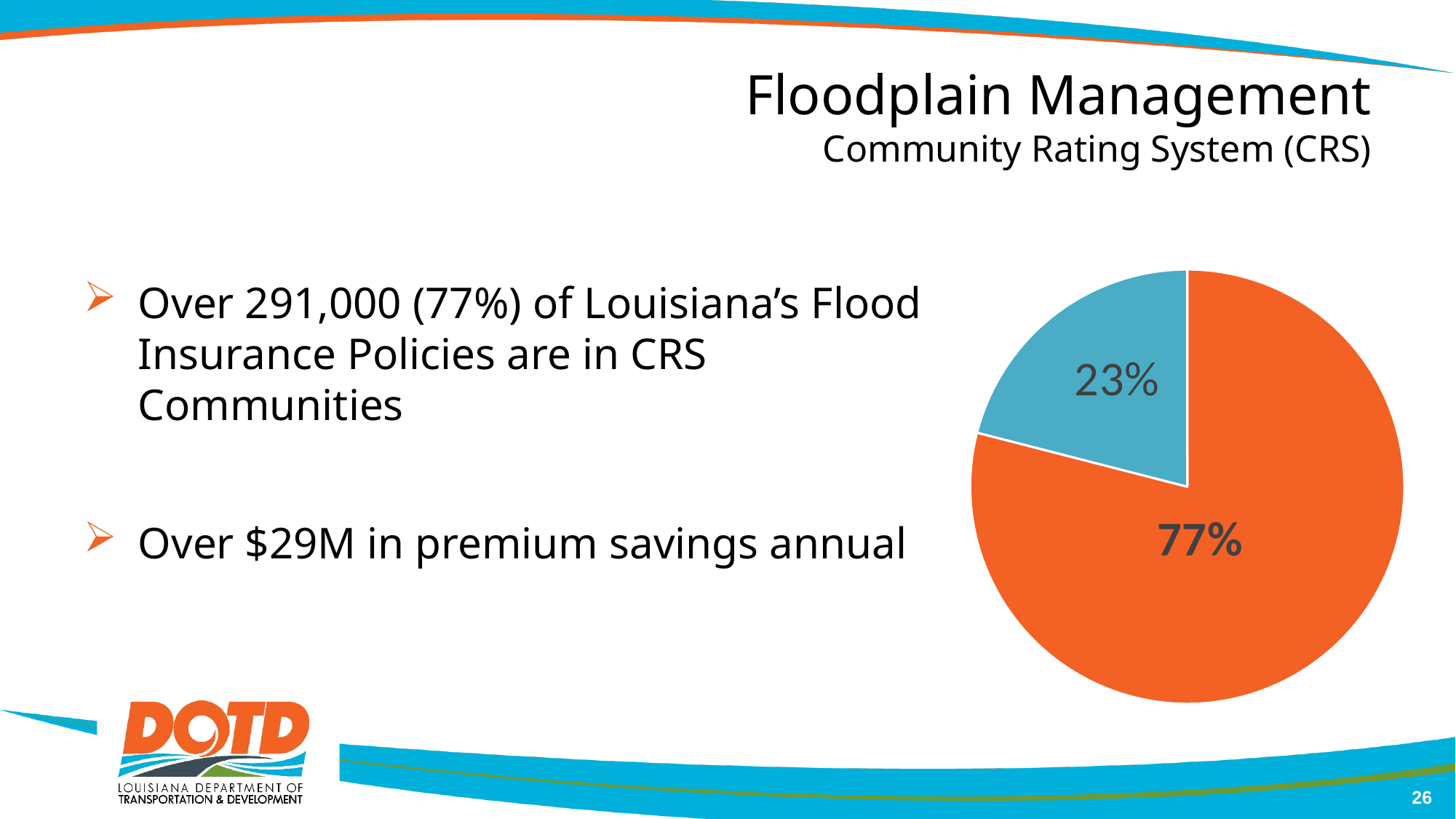
How many slices does the pie chart have? 2 Does the pie chart include a legend? No Is the orange slice or the blue slice larger? the orange slice Which slice of the pie chart is the largest? the orange slice (77%) What kind of chart is shown on the slide? pie chart What share of the pie does the blue slice represent? 23% What percentage is shown on the blue slice of the pie chart? 23% What is the difference in percentage points between the orange slice and the blue slice? 54 What percentage is shown on the orange slice of the pie chart? 77% What colour is the slice labelled 77%? orange Is the value of the blue slice greater or less than 50%? less Which slice of the pie chart is the smallest? the blue slice (23%)